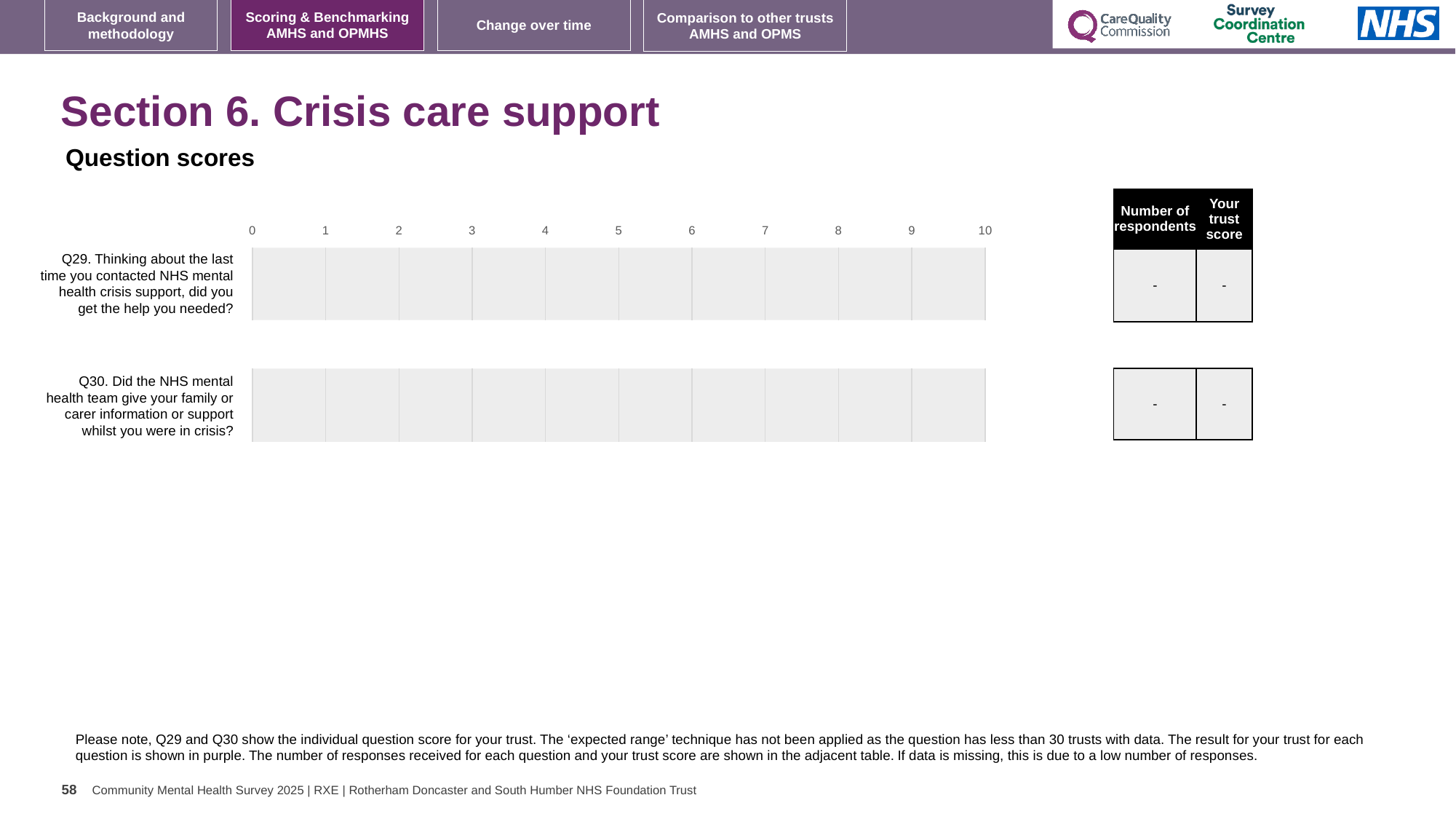
What is the 'Number of respondents' value shown for Q30 in the adjacent table? - What kind of chart is shown on the slide? bar chart What is the highest value shown on the chart's horizontal axis? 10 What is the heading shown above the chart? Question scores What is the 'Your trust score' value shown for Q29 in the adjacent table? - How many questions (categories) are listed on the chart? 2